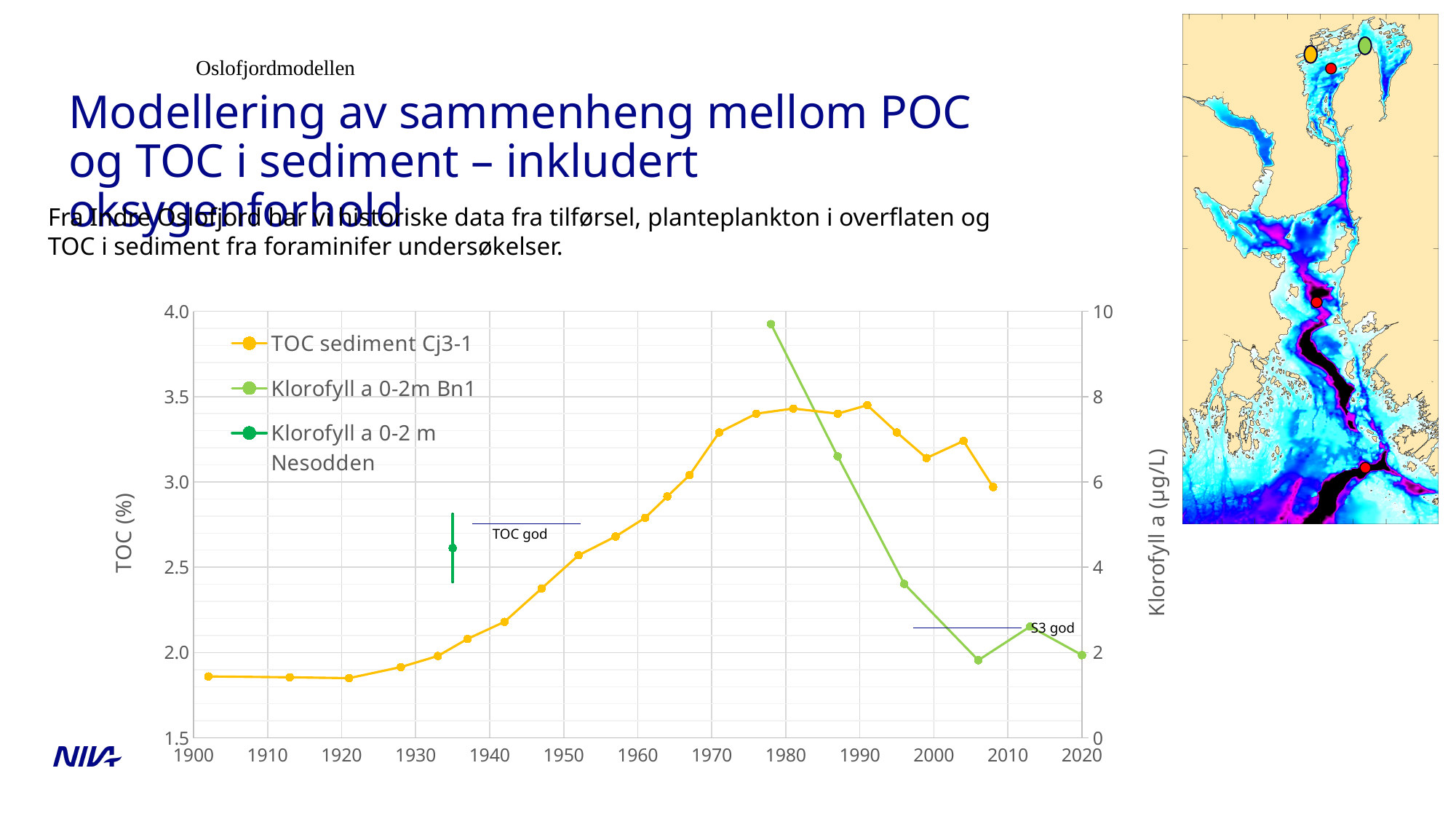
Is the TOC sediment Cj3-1 value around 1990 greater or less than 3.0? greater What is the label of the right vertical axis? Klorofyll a (µg/L) What kind of chart is shown on the slide? line chart Does the TOC sediment Cj3-1 series rise or fall between 1920 and 1990? rise Is the TOC sediment Cj3-1 value around 1900 greater or less than 2.0? less Is the Klorofyll a 0-2m Bn1 value around 1978 greater or less than 8 on the right axis? greater Which is larger for TOC sediment Cj3-1: the value around 1991 or the value around 2008? 1991 Does the Klorofyll a 0-2m Bn1 series rise or fall between 1978 and 2006? fall How many series does the chart legend list? 3 What is the label of the left vertical axis? TOC (%)